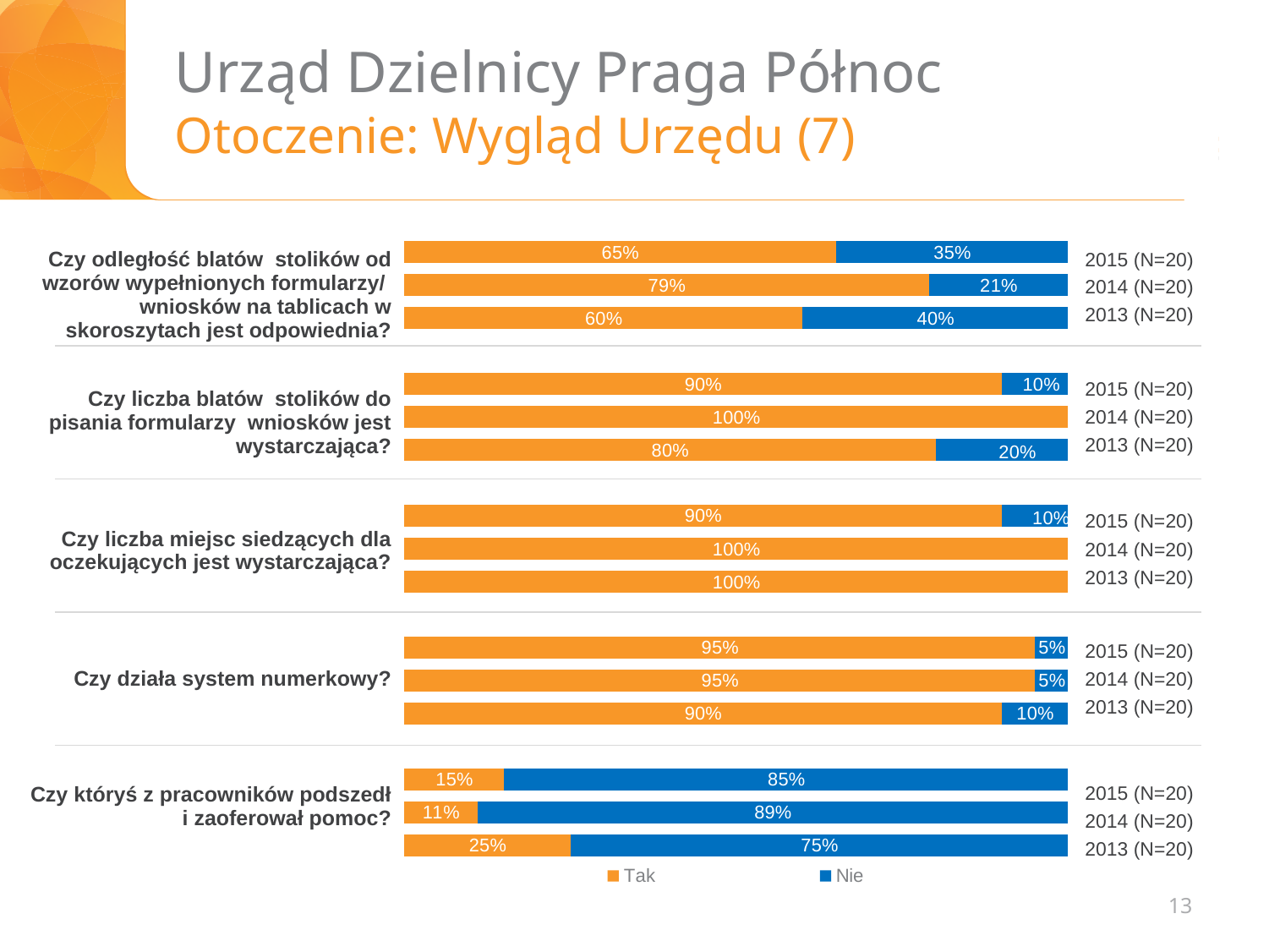
What is the sample size (N) shown for each year on the chart? N=20 What percentage answered "Tak" in 2014 to the question "Czy któryś z pracowników podszedł i zaoferował pomoc?" 11% For the question "Czy liczba blatów stolików do pisania formularzy wniosków jest wystarczająca?", which year had the highest "Tak" share? 2014 (N=20) How many survey questions are shown on the chart? 5 For the question "Czy odległość blatów stolików od wzorów wypełnionych formularzy/wniosków na tablicach w skoroszytach jest odpowiednia?", which year had the lowest "Tak" share? 2013 (N=20) What percentage answered "Nie" in 2013 to the question "Czy odległość blatów stolików od wzorów wypełnionych formularzy/wniosków na tablicach w skoroszytach jest odpowiednia?" 40% What type of chart is shown on the slide? Stacked bar chart What percentage answered "Tak" in 2015 to the question "Czy działa system numerkowy?" 95% What is the difference between the "Nie" share in 2015 and in 2014 for the question "Czy odległość blatów stolików od wzorów wypełnionych formularzy/wniosków na tablicach w skoroszytach jest odpowiednia?" 14 percentage points Which colour represents the "Nie" answers in the chart? Blue For the question "Czy któryś z pracowników podszedł i zaoferował pomoc?", was the "Nie" share larger in 2015 or in 2013? 2015 How many series does the legend list? 2